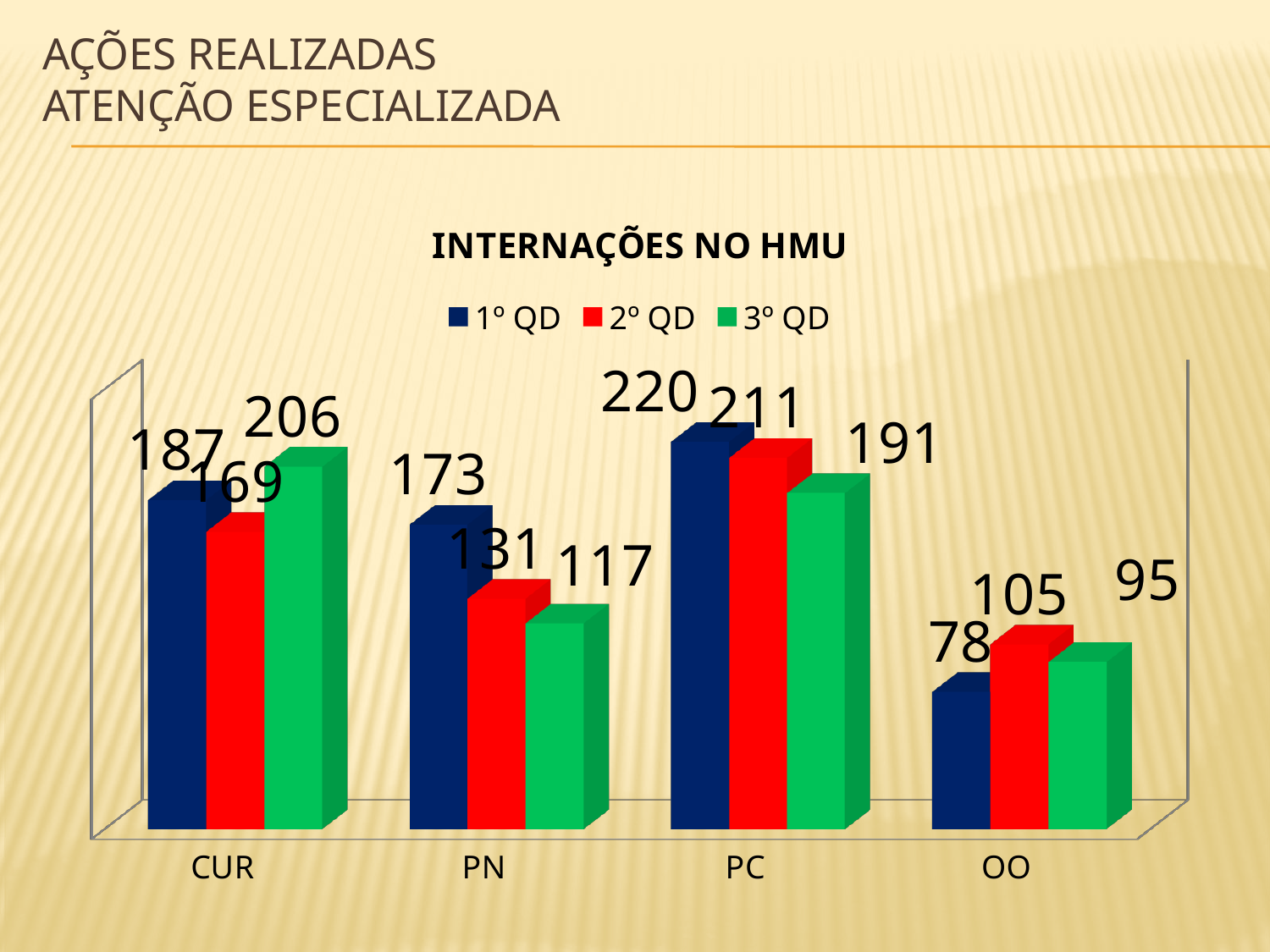
What is the value for 2º QD in the OO category? 105 How many categories are shown on the x axis? 4 How many series does the legend list? 3 Which category has the highest 1º QD value? PC What kind of chart is shown on the slide? Bar chart What is the value for 1º QD in the CUR category? 187 Which category has the lowest 3º QD value? OO What is the difference between the 1º QD and 3º QD values for PC? 29 What is the value for 3º QD in the PN category? 117 What is the title of the chart? INTERNAÇÕES NO HMU Which is larger for PN: the 1º QD value or the 2º QD value? 1º QD What is the difference between the 3º QD and 1º QD values for CUR? 19